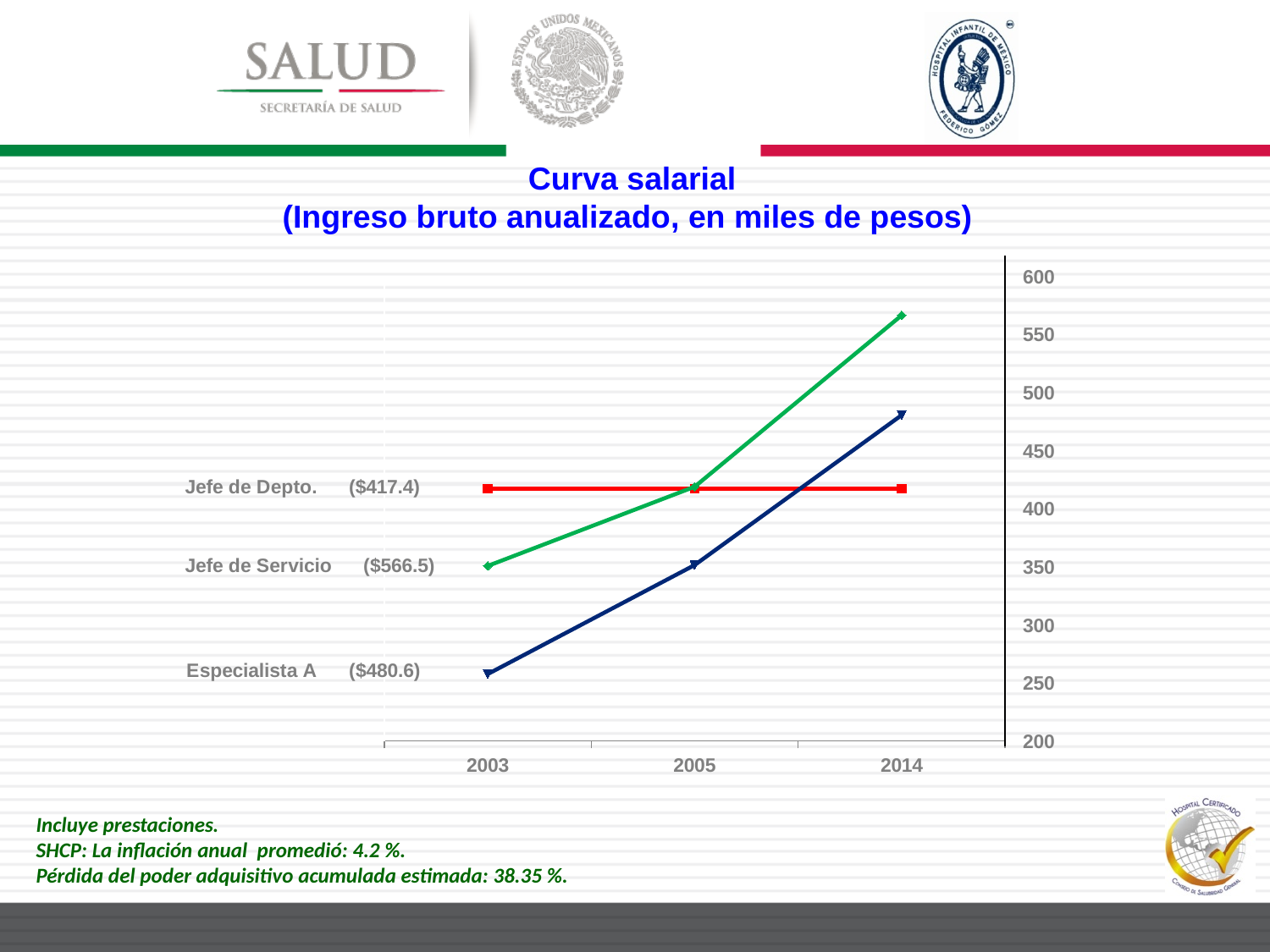
Which series has the lowest value in 2003? Especialista A What is the title of the chart? Curva salarial (Ingreso bruto anualizado, en miles de pesos) How many series does the chart show? 3 Does the Especialista A line rise or fall from 2003 to 2014? rise What value is printed next to the Especialista A label? $480.6 What value is printed next to the Jefe de Servicio label? $566.5 What value is printed next to the Jefe de Depto. label? $417.4 How many years are shown on the x axis? 3 Is the value for Especialista A in 2003 greater or less than 300? less Which series has the highest value in 2014? Jefe de Servicio What kind of chart is shown on the slide? line chart Is the value for Jefe de Servicio in 2014 greater or less than 550? greater